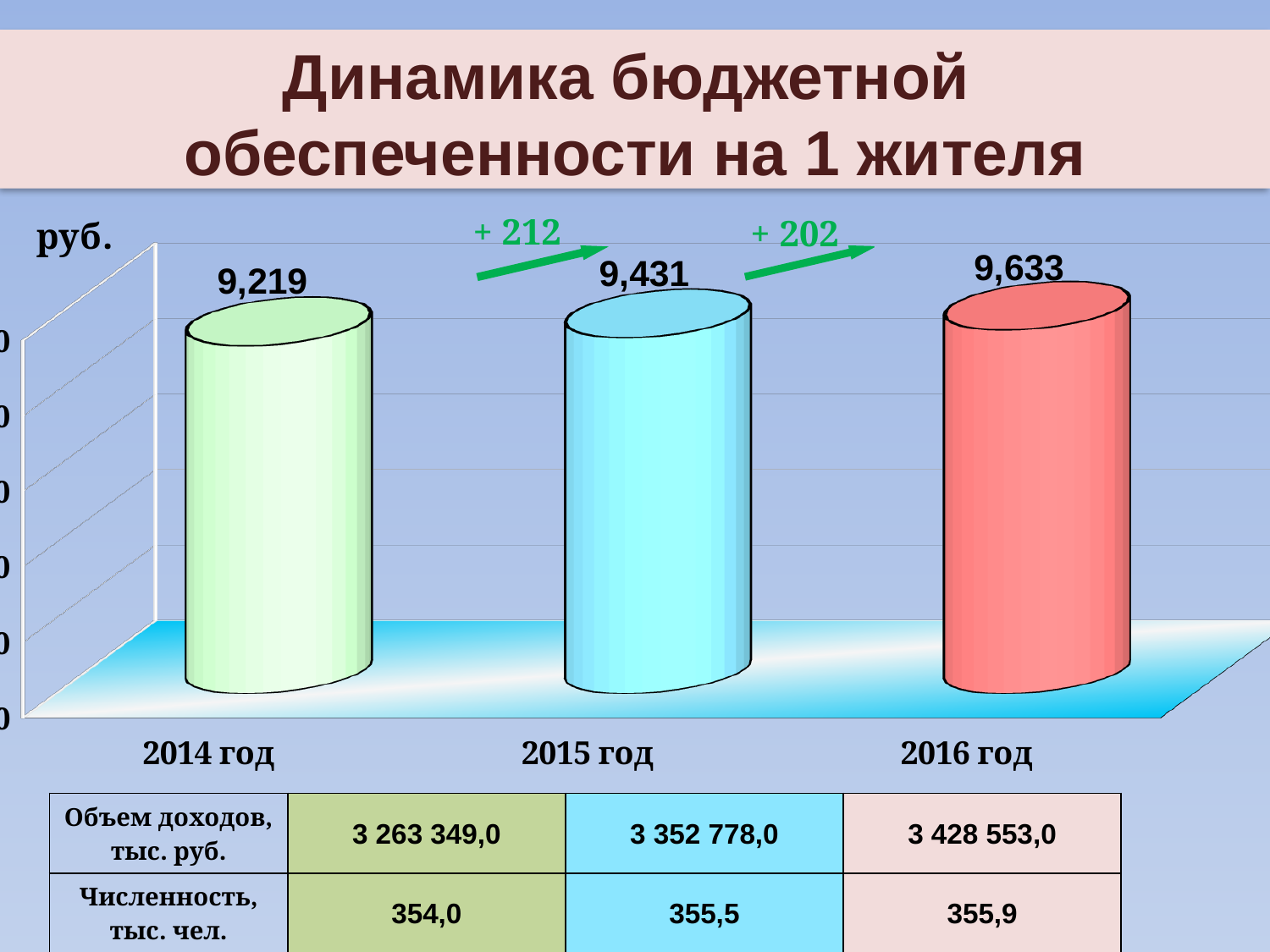
Do the values rise or fall from 2014 год to 2016 год? rise What is the difference between the values for 2015 год and 2014 год? 212 What is the value for 2016 год? 9,633 What is the difference between the values for 2016 год and 2015 год? 202 What is the difference between the values for 2016 год and 2014 год? 414 What is the value for 2014 год? 9,219 What is the value for 2015 год? 9,431 What kind of chart is shown on the slide? bar chart Which is larger, the value for 2015 год or the value for 2016 год? 2016 год Which year has the highest value? 2016 год Which year has the lowest value? 2014 год How many years are shown on the chart? 3